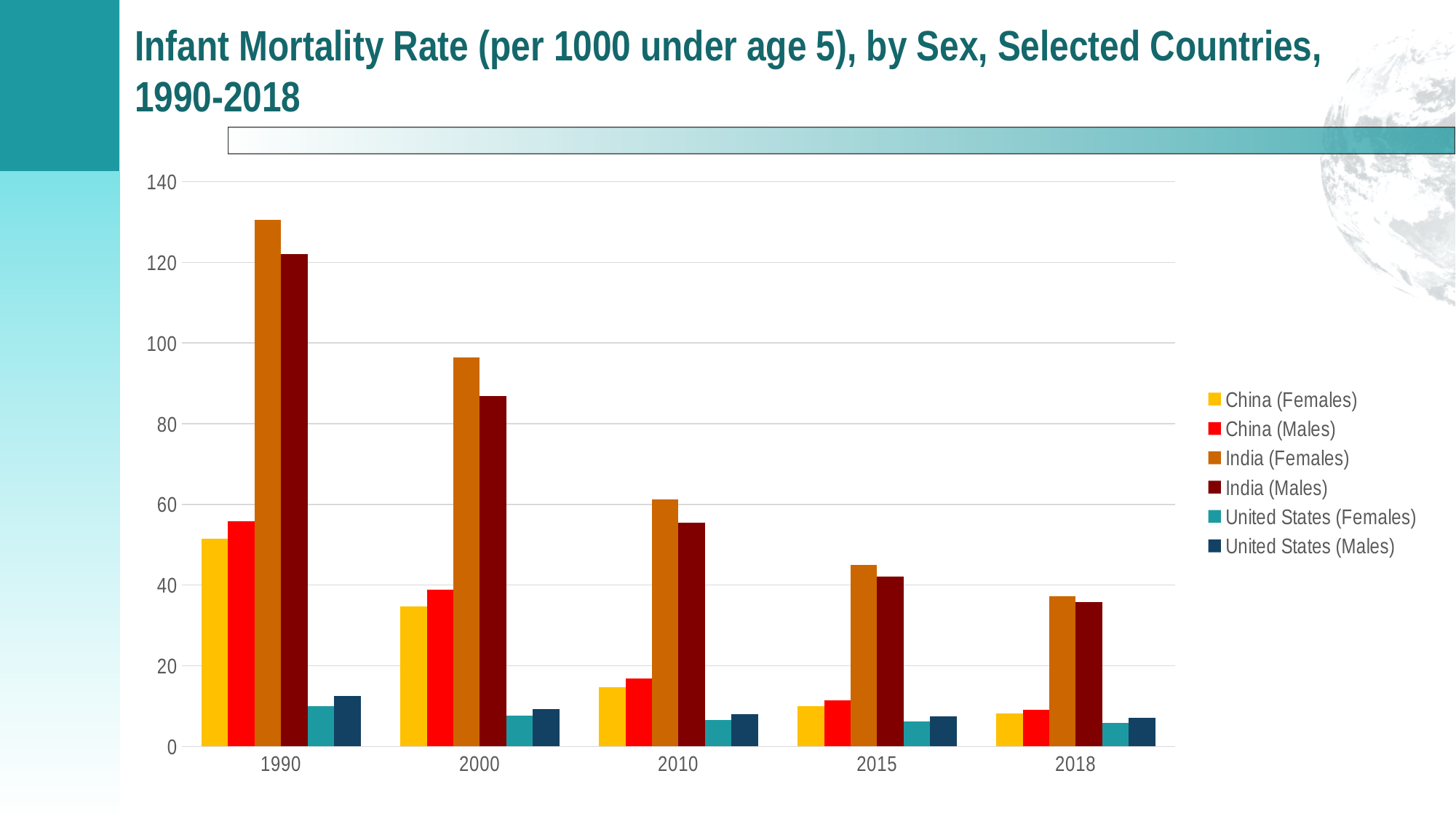
Is the value for India (Females) in 1990 greater or less than 120? greater Do the India (Females) values rise or fall from 1990 to 2018? fall In 2000, which is larger: India (Females) or India (Males)? India (Females) Is the value for China (Females) in 2010 greater or less than 20? less Is the value for India (Males) in 2000 greater or less than 80? greater Which series has the lowest value in 1990? United States (Females) In 1990, which is larger: China (Males) or China (Females)? China (Males) In which year is the India (Females) value highest? 1990 What kind of chart is shown on the slide? Bar chart How many series does the legend list? 6 How many years are shown along the x axis? 5